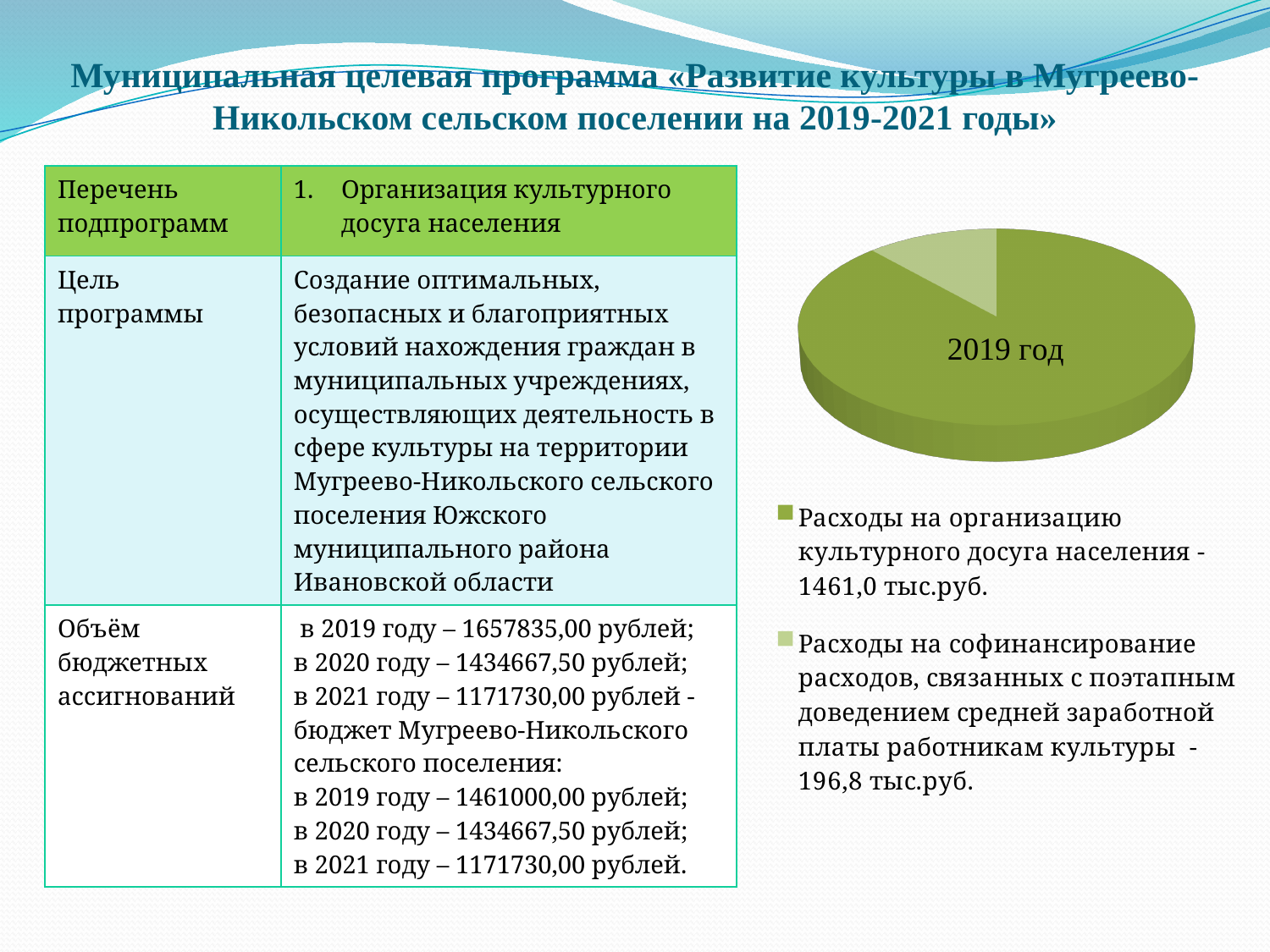
What is the value for «Расходы на организацию культурного досуга населения»? 1461,0 тыс.руб. How many slices does the pie chart have? 2 What is the total of the two values shown for the pie chart? 1657,8 тыс.руб. What year is labelled on the pie chart? 2019 год Which is larger: expenses on organising cultural leisure (Расходы на организацию культурного досуга населения) or expenses on co-financing wage increases (Расходы на софинансирование)? Расходы на организацию культурного досуга населения Which category takes the smallest slice of the pie chart? Расходы на софинансирование расходов, связанных с поэтапным доведением средней заработной платы работникам культуры What is the difference between the two values shown for the pie chart, 1461,0 тыс.руб. and 196,8 тыс.руб.? 1264,2 тыс.руб. What is the value for «Расходы на софинансирование расходов, связанных с поэтапным доведением средней заработной платы работникам культуры»? 196,8 тыс.руб. What kind of chart is shown on the slide? pie chart Which category takes the largest slice of the pie chart? Расходы на организацию культурного досуга населения What colour is the larger slice of the pie chart? dark green